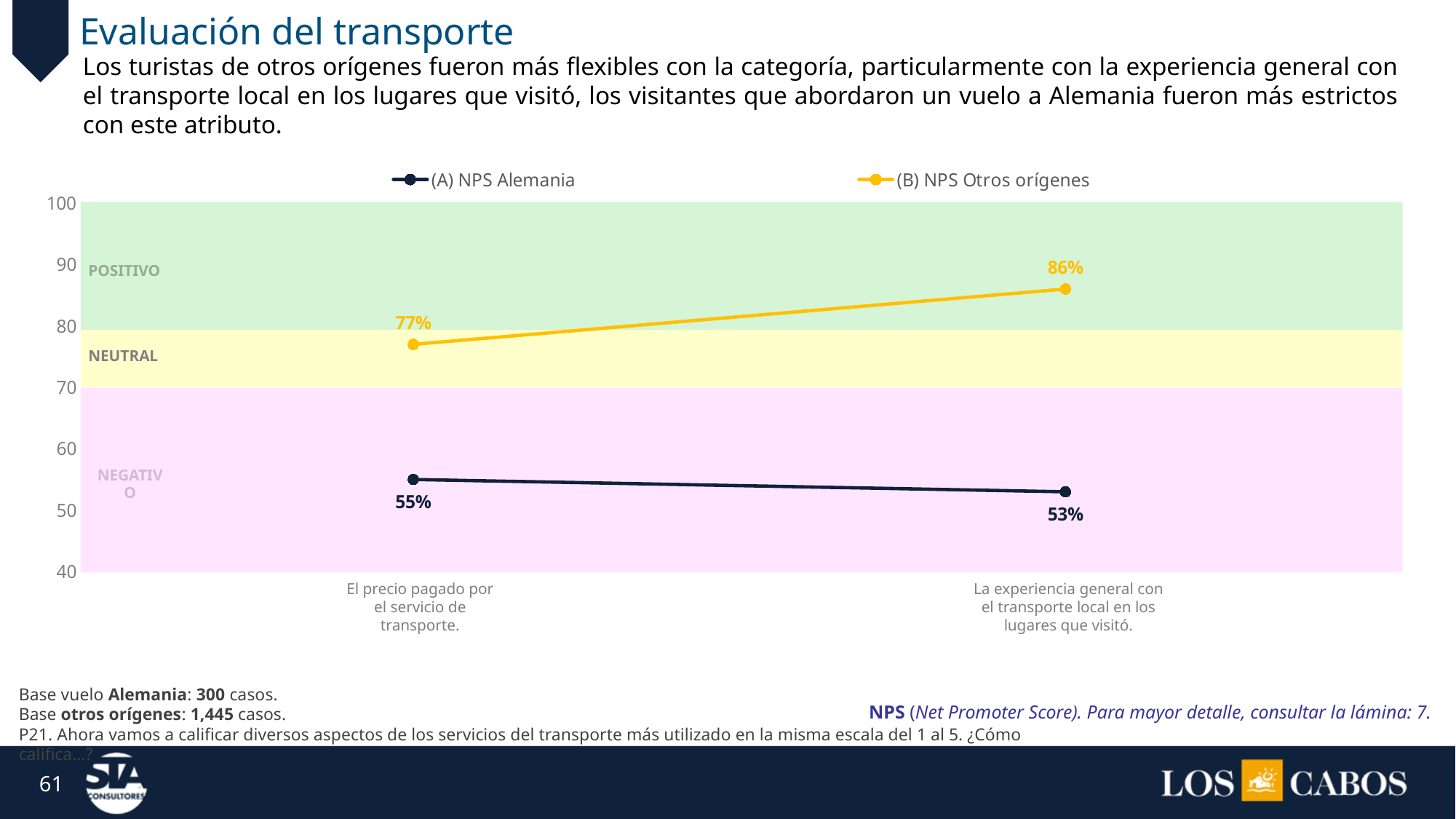
What is the difference between the NPS for Otros orígenes and Alemania for 'La experiencia general con el transporte local en los lugares que visitó'? 33 percentage points What is the NPS for Otros orígenes for 'La experiencia general con el transporte local en los lugares que visitó'? 86% Which series has the higher value for 'El precio pagado por el servicio de transporte', NPS Alemania or NPS Otros orígenes? (B) NPS Otros orígenes What is the NPS for Alemania for 'El precio pagado por el servicio de transporte'? 55% What is the NPS for Otros orígenes for 'El precio pagado por el servicio de transporte'? 77% What kind of chart is shown on the slide? Line chart What is the NPS for Alemania for 'La experiencia general con el transporte local en los lugares que visitó'? 53% Which category has the lowest NPS Alemania value? La experiencia general con el transporte local en los lugares que visitó. How many series does the legend list? 2 Does the NPS Alemania line rise or fall from the first category to the second? Fall Which category has the highest NPS Otros orígenes value? La experiencia general con el transporte local en los lugares que visitó. What is the difference between the two NPS Otros orígenes values? 9 percentage points